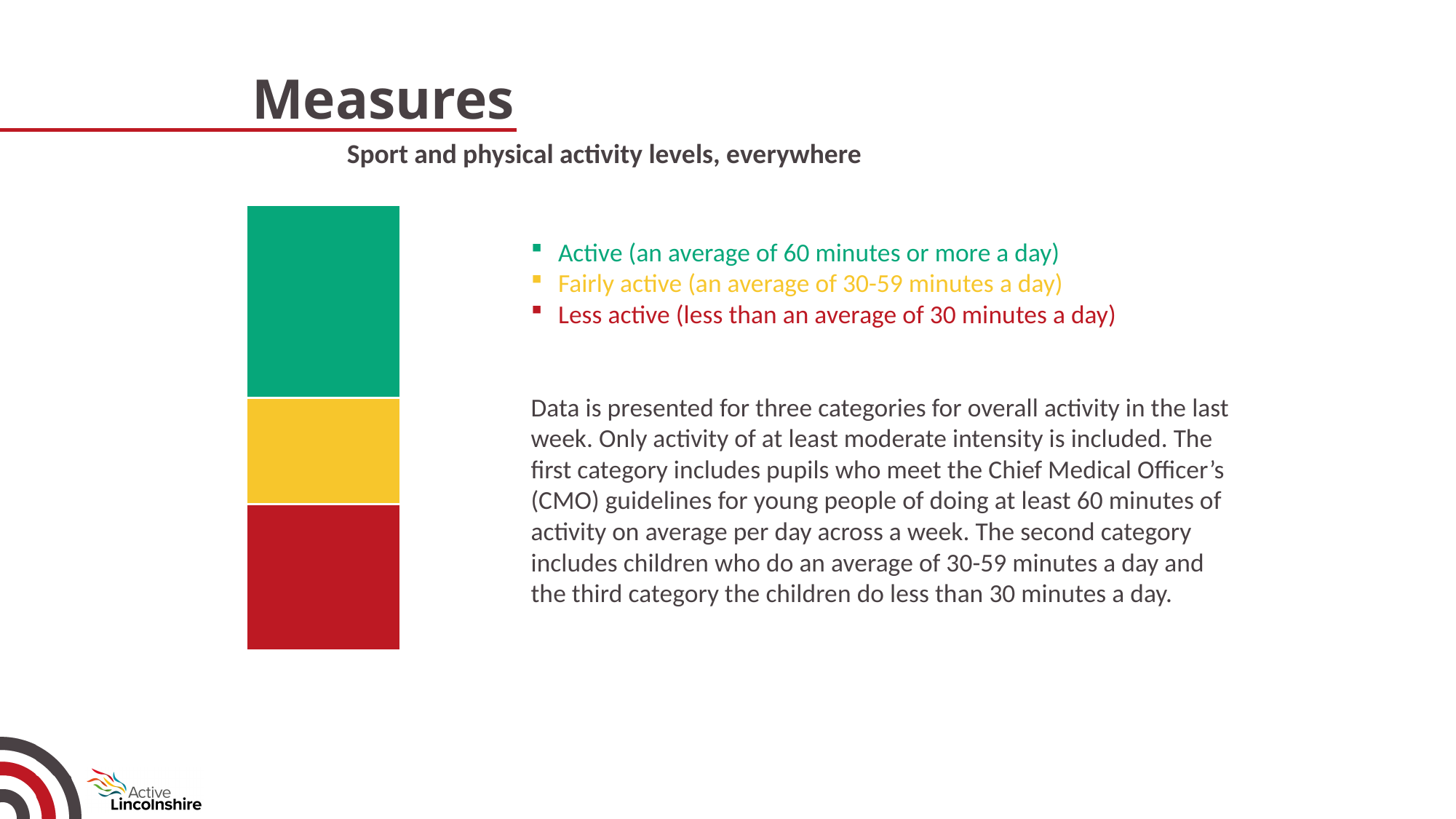
Which segment of the stacked bar is the largest? Active (an average of 60 minutes or more a day) What kind of chart is shown on the slide? A stacked bar chart How many series does the legend list? 3 Which segment is larger, Less active or Fairly active? Less active Which segment of the stacked bar is the smallest? Fairly active (an average of 30-59 minutes a day) What colour represents the Less active category in the chart? Red Which segment is larger, Active or Fairly active? Active How many segments make up the stacked bar? 3 What colour represents the Active category in the chart? Green